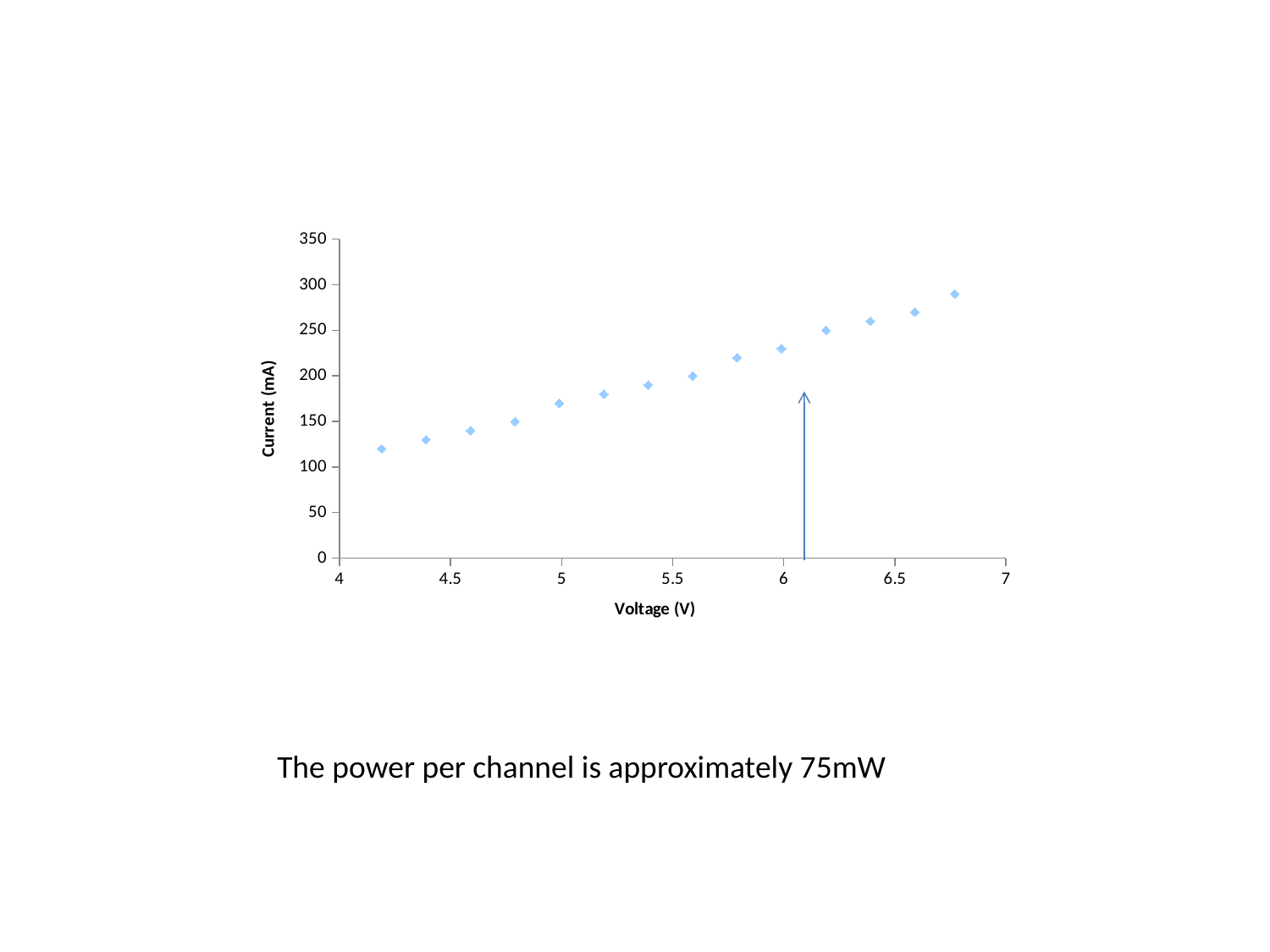
Which is larger, the current at 5 V or the current at 6 V? the current at 6 V Is the current at the lowest plotted voltage (about 4.2 V) greater or less than 150 mA? less Is the current at the highest plotted voltage (about 6.8 V) greater or less than 300 mA? less What is the label of the y axis? Current (mA) Does the current rise or fall as voltage increases along the x axis? rises What kind of chart is shown on the slide? scatter chart Is the current at 6 V greater or less than 200 mA? greater What is the label of the x axis? Voltage (V) What is the maximum value shown on the y axis? 350 How many data points are plotted on the chart? 14